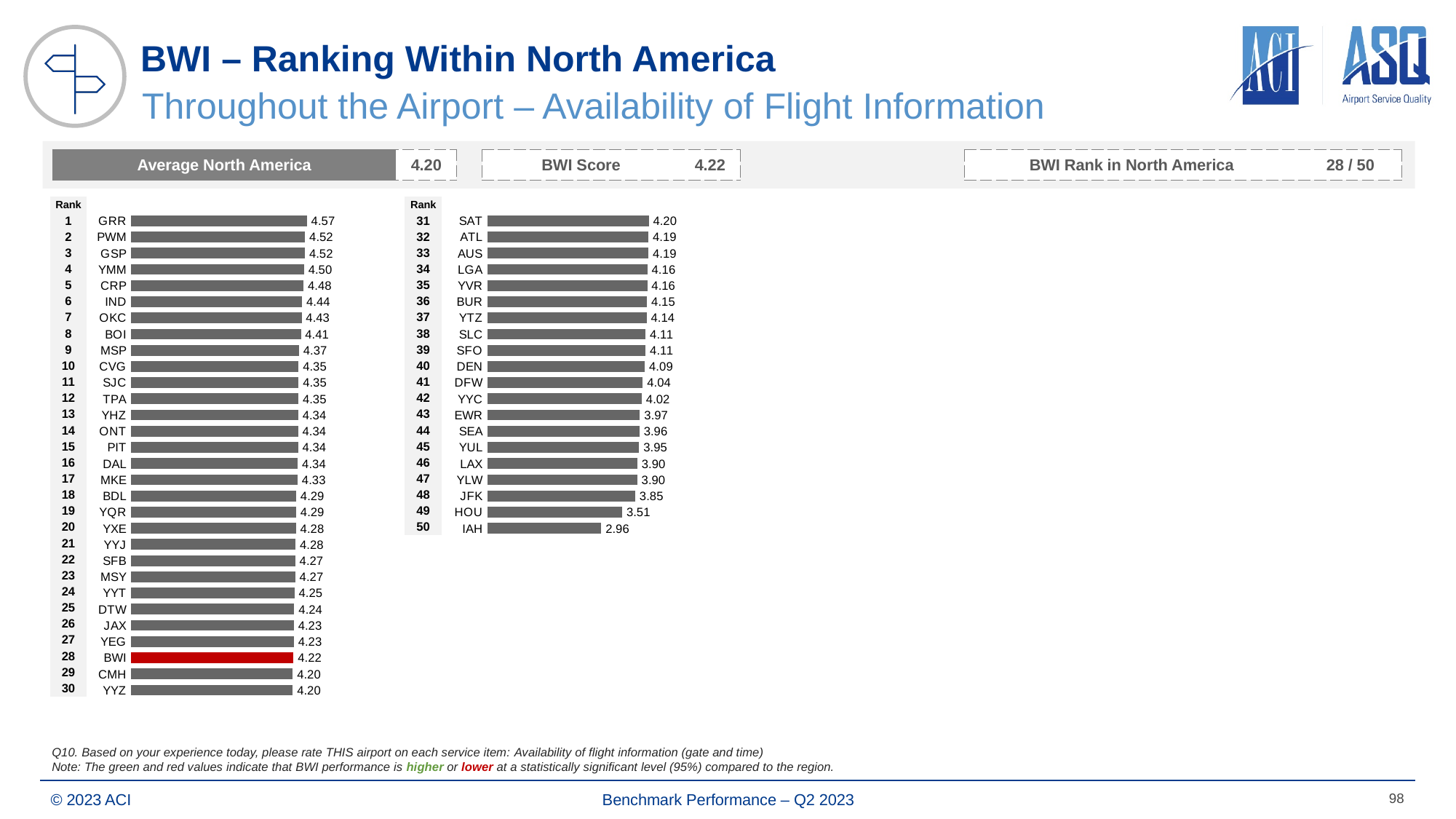
What kind of chart is used to show the airport rankings? Bar chart What is the score shown for IAH? 2.96 Which has a higher score, MSP or DEN? MSP What is the score shown for HOU? 3.51 Do the scores rise or fall as the rank number increases from 1 to 50? Fall What rank does BWI hold in North America according to the chart? 28 What colour is the bar for BWI in the ranking chart? Red What is the score shown for BWI in the ranking chart? 4.22 Which airport has the lowest score in the ranking chart? IAH Which airport has the highest score in the ranking chart? GRR What is the difference between the score for GRR and the score for BWI? 0.35 How many airports are ranked in the chart? 50